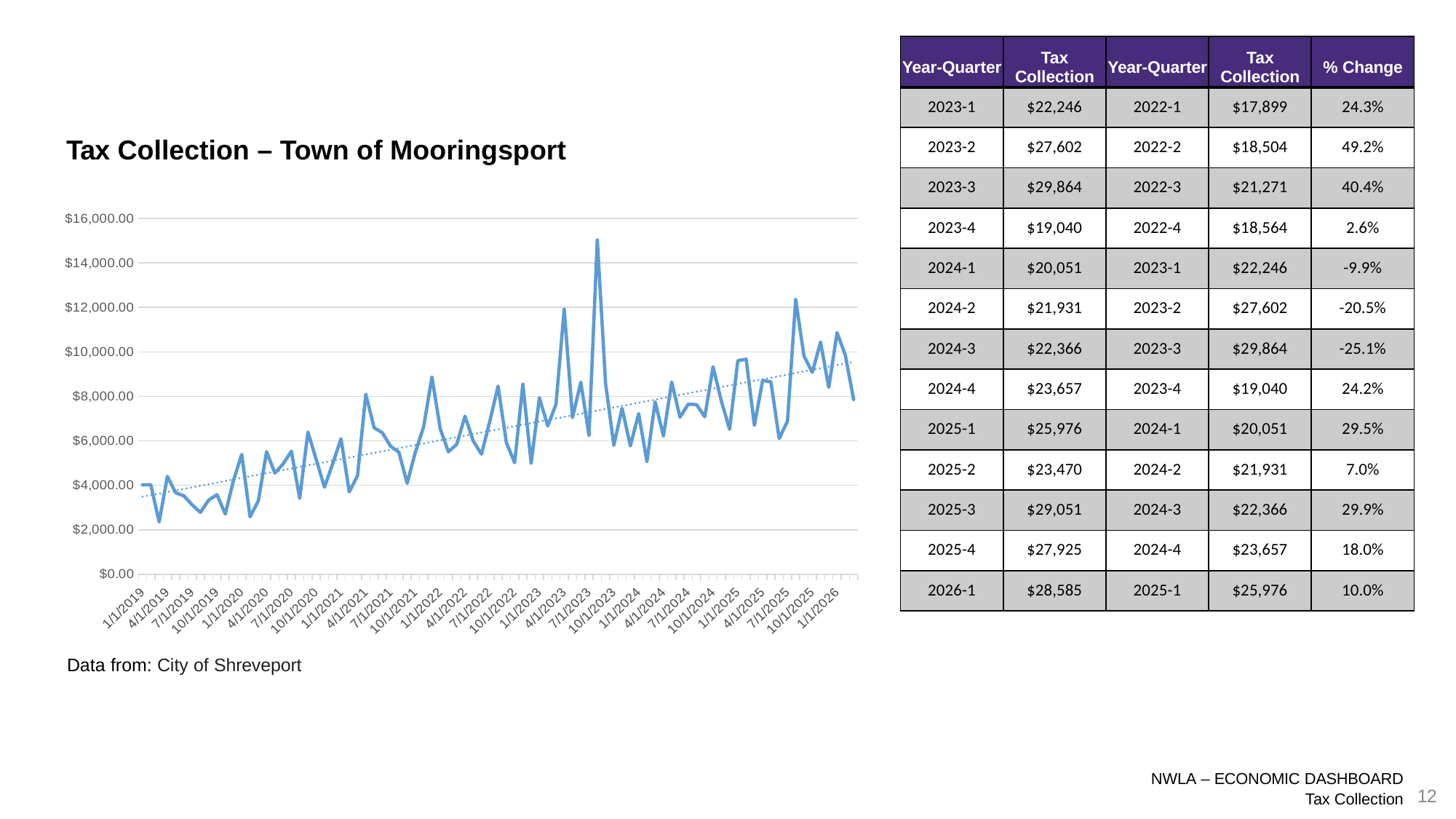
Does the highest peak on the chart occur in 2023 or in 2025? 2023 What is the first date label on the x axis of the chart? 1/1/2019 Is the last plotted point on the chart greater or less than $10,000.00? less What kind of chart is shown on the slide? line chart Is the last plotted point on the chart greater or less than $6,000.00? greater What is the title of the chart? Tax Collection – Town of Mooringsport Is the lowest point on the chart greater or less than $4,000.00? less Overall, do the values in the chart rise or fall from 1/1/2019 to 1/1/2026? rise What is the highest value labelled on the y axis of the chart? $16,000.00 How many labelled tick marks are on the y axis of the chart? 9 How many data series are plotted in the chart (excluding the dotted trendline)? 1